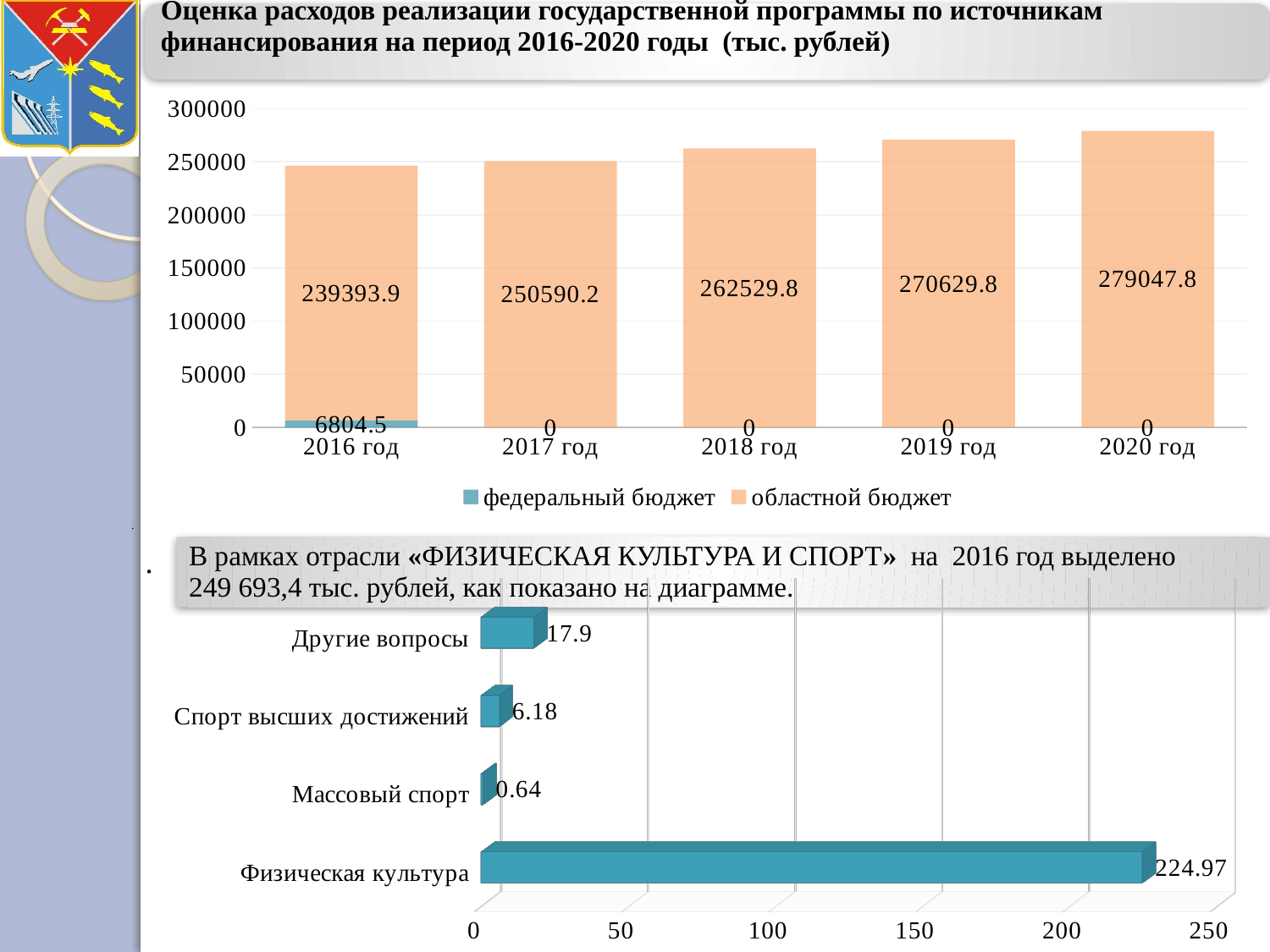
In the top chart, what is the difference between the областной бюджет values for 2020 год and 2016 год? 39653.9 In the top chart, what is the total of the stacked bar for 2016 год? 246198.4 In the bottom chart, which category has the lowest value? Массовый спорт In the top chart, what is the value of федеральный бюджет for 2019 год? 0 What kind of chart is the bottom chart? bar chart In the top chart, do the областной бюджет values rise or fall from 2016 год to 2020 год? rise In the bottom chart, what is the difference between Физическая культура and Другие вопросы? 207.07 How many series does the legend of the top chart list? 2 In the top chart, what is the value of областной бюджет for 2018 год? 262529.8 In the bottom chart, what is the value for Спорт высших достижений? 6.18 In the top chart, what is the value of федеральный бюджет for 2016 год? 6804.5 In the top chart, which year has the highest областной бюджет value? 2020 год